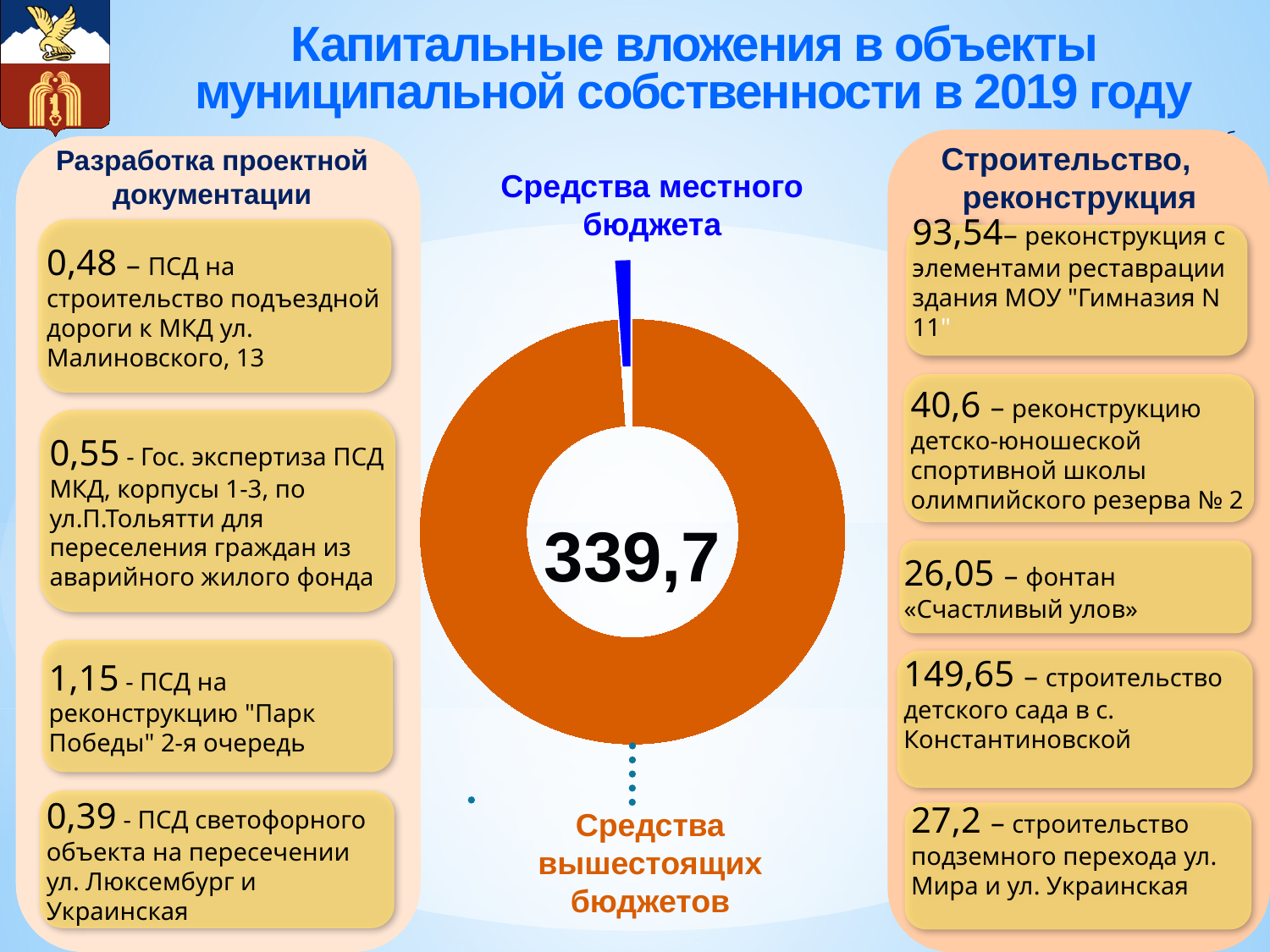
What colour is the Средства местного бюджета segment of the donut chart? Blue How many segments does the donut chart have? 2 What colour is the Средства вышестоящих бюджетов segment of the donut chart? Orange What value is printed in the centre of the donut chart? 339,7 Which segment of the donut chart is the largest? Средства вышестоящих бюджетов Which segment of the donut chart is larger: Средства местного бюджета or Средства вышестоящих бюджетов? Средства вышестоящих бюджетов Which segment of the donut chart is the smallest? Средства местного бюджета What kind of chart is shown in the centre of the slide? Donut (pie) chart